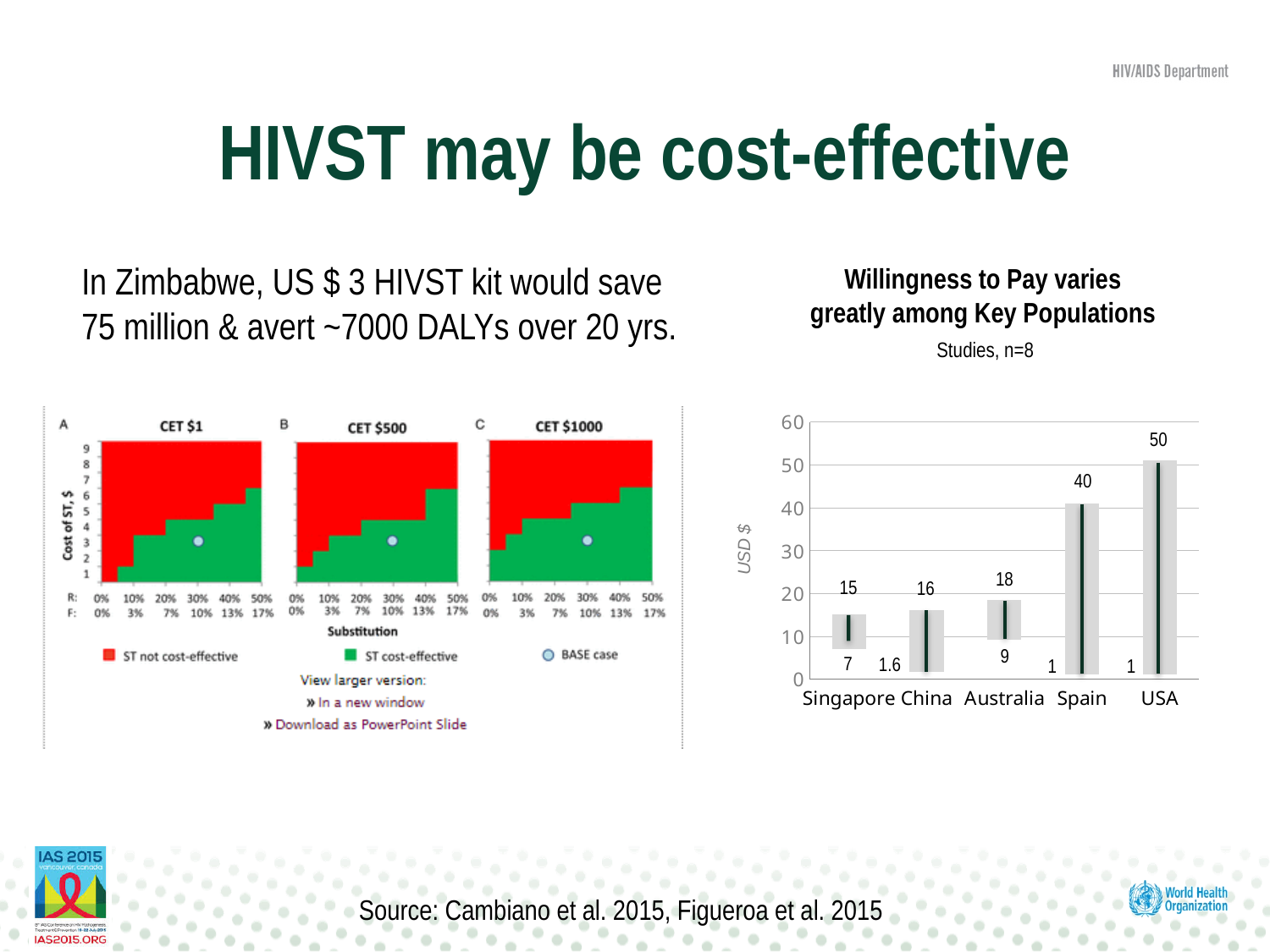
In the 'Willingness to Pay varies greatly among Key Populations' chart, what is the upper value shown for USA? 50 In the 'Willingness to Pay varies greatly among Key Populations' chart, which country has the highest upper value? USA In the cost-effectiveness chart on the left of the slide, how many panels (CET thresholds) are shown? 3 In the 'Willingness to Pay varies greatly among Key Populations' chart, do the upper values rise or fall from Singapore to USA along the x axis? rise In the 'Willingness to Pay varies greatly among Key Populations' chart, what is the upper value shown for Australia? 18 In the 'Willingness to Pay varies greatly among Key Populations' chart, what is the difference between the upper values for USA and Spain? 10 In the 'Willingness to Pay varies greatly among Key Populations' chart, what is the lower value shown for China? 1.6 In the 'Willingness to Pay varies greatly among Key Populations' chart, which country has the lowest upper value? Singapore In the 'Willingness to Pay varies greatly among Key Populations' chart, which has the larger upper value, Australia or China? Australia What is the y-axis label of the 'Willingness to Pay varies greatly among Key Populations' chart? USD $ What kind of chart is the 'Willingness to Pay varies greatly among Key Populations' chart? bar chart In the 'Willingness to Pay varies greatly among Key Populations' chart, how many countries are shown on the x axis? 5